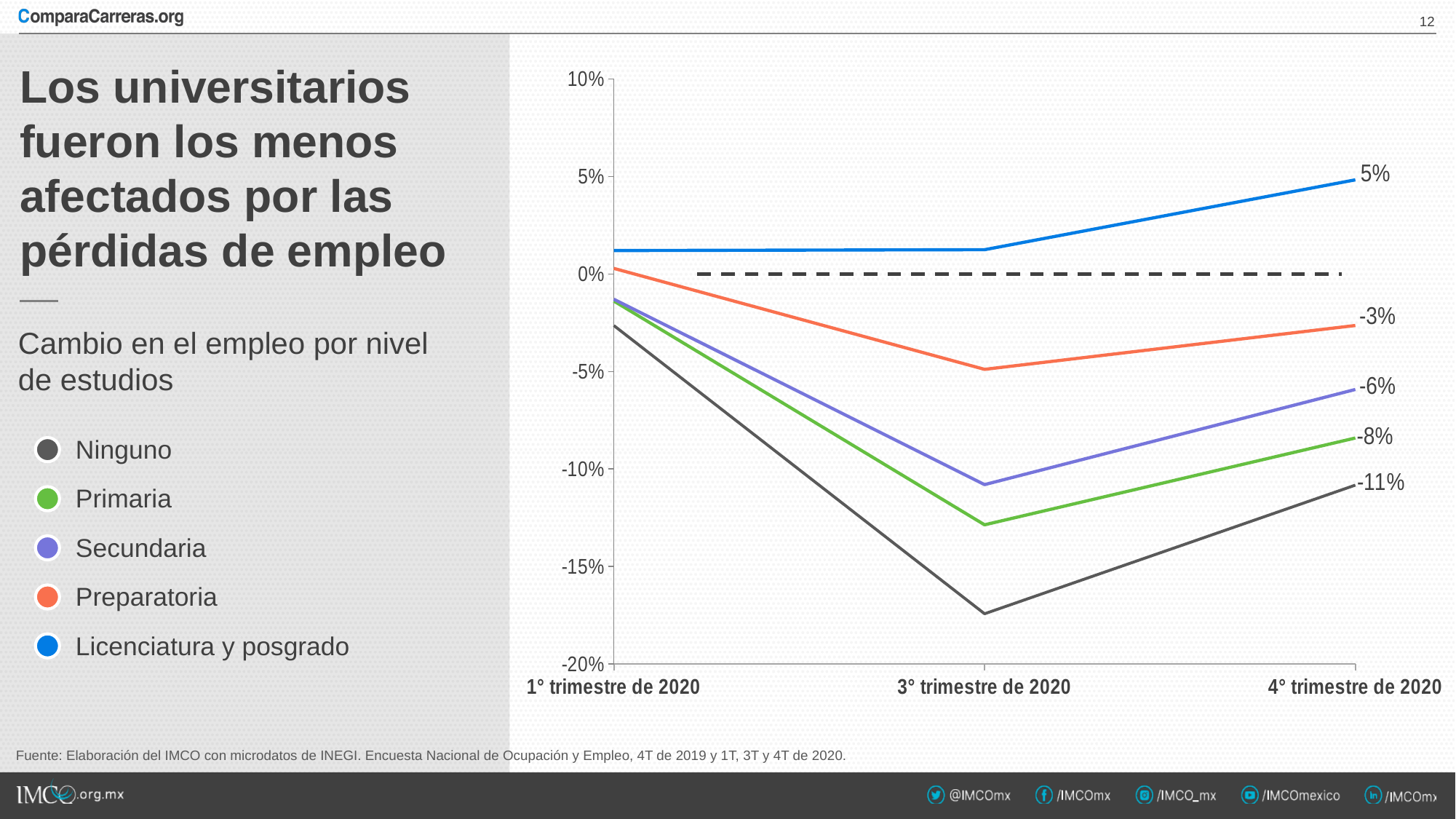
What is the value for Ninguno in the 4° trimestre de 2020? -11% How many series does the legend list? 5 Which education level has the lowest value in the 3° trimestre de 2020? Ninguno How many time points are shown on the x axis? 3 What is the value for Preparatoria in the 4° trimestre de 2020? -3% Which education level has the highest value in the 4° trimestre de 2020? Licenciatura y posgrado What is the difference between the 4° trimestre de 2020 values for Licenciatura y posgrado and Ninguno? 16 percentage points What is the value for Primaria in the 4° trimestre de 2020? -8% What kind of chart is shown on the slide? line chart Which series is drawn in blue? Licenciatura y posgrado What is the value for Licenciatura y posgrado in the 4° trimestre de 2020? 5% Is the value for Ninguno in the 3° trimestre de 2020 greater or less than -15%? less